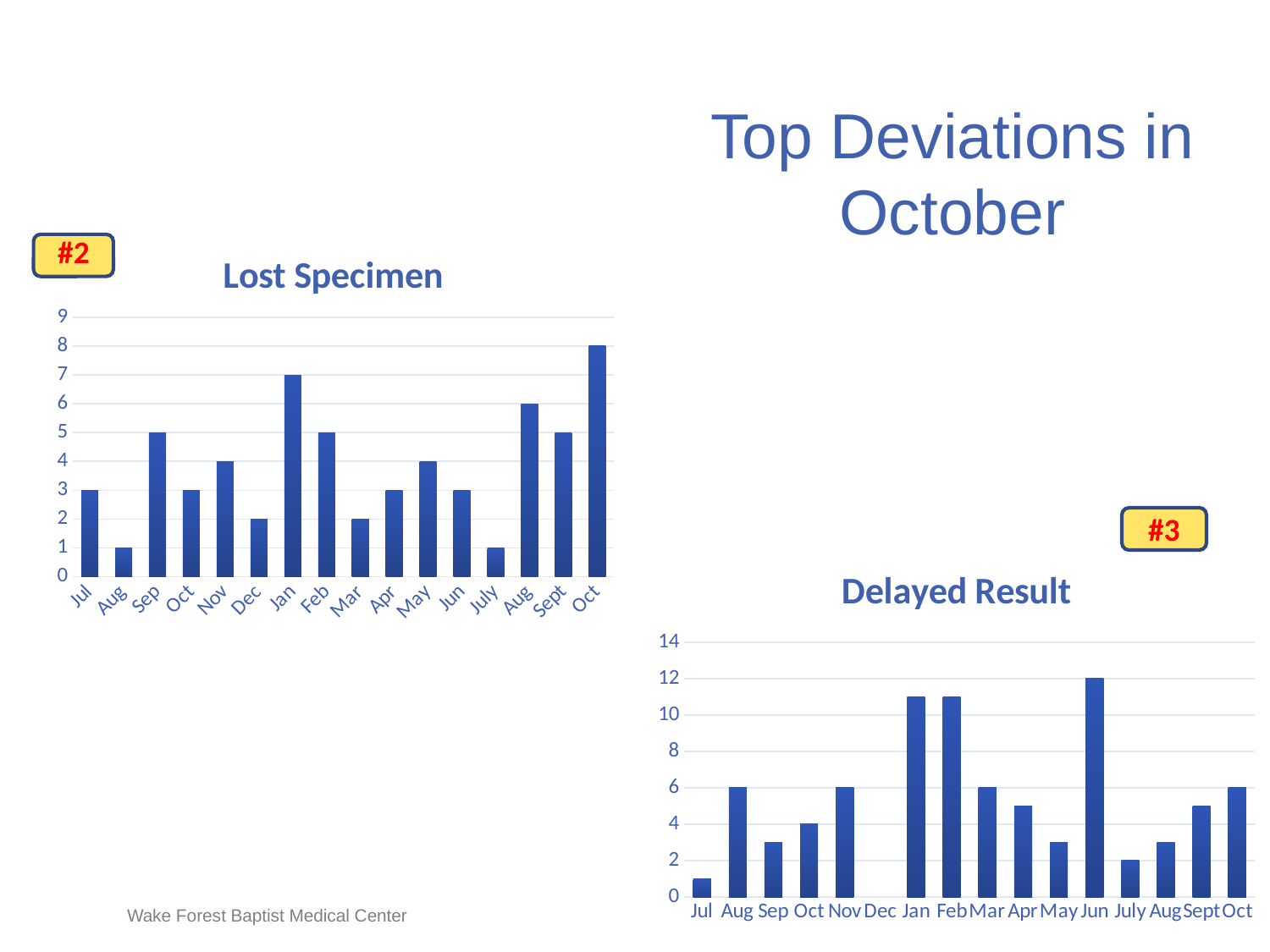
In the Lost Specimen chart, what is the value for the last Oct bar (rightmost)? 8 In the Lost Specimen chart, which is larger, the value for Sep or the value for Nov? Sep In the Lost Specimen chart, what is the value for Jan? 7 In the Delayed Result chart, is the value for Jul greater or less than 2? less What label is shown in the yellow box next to the Delayed Result chart? #3 In the Lost Specimen chart, what is the difference between the Jan value and the Dec value? 5 In the Delayed Result chart, what is the value for Jun? 12 In the Delayed Result chart, is the value for Jan greater or less than 10? greater In the Lost Specimen chart, which month has the highest value? Oct (rightmost) How many month categories are shown on the x axis of the Lost Specimen chart? 16 What type of chart is the Delayed Result chart? Bar chart In the Delayed Result chart, which month has the highest value? Jun